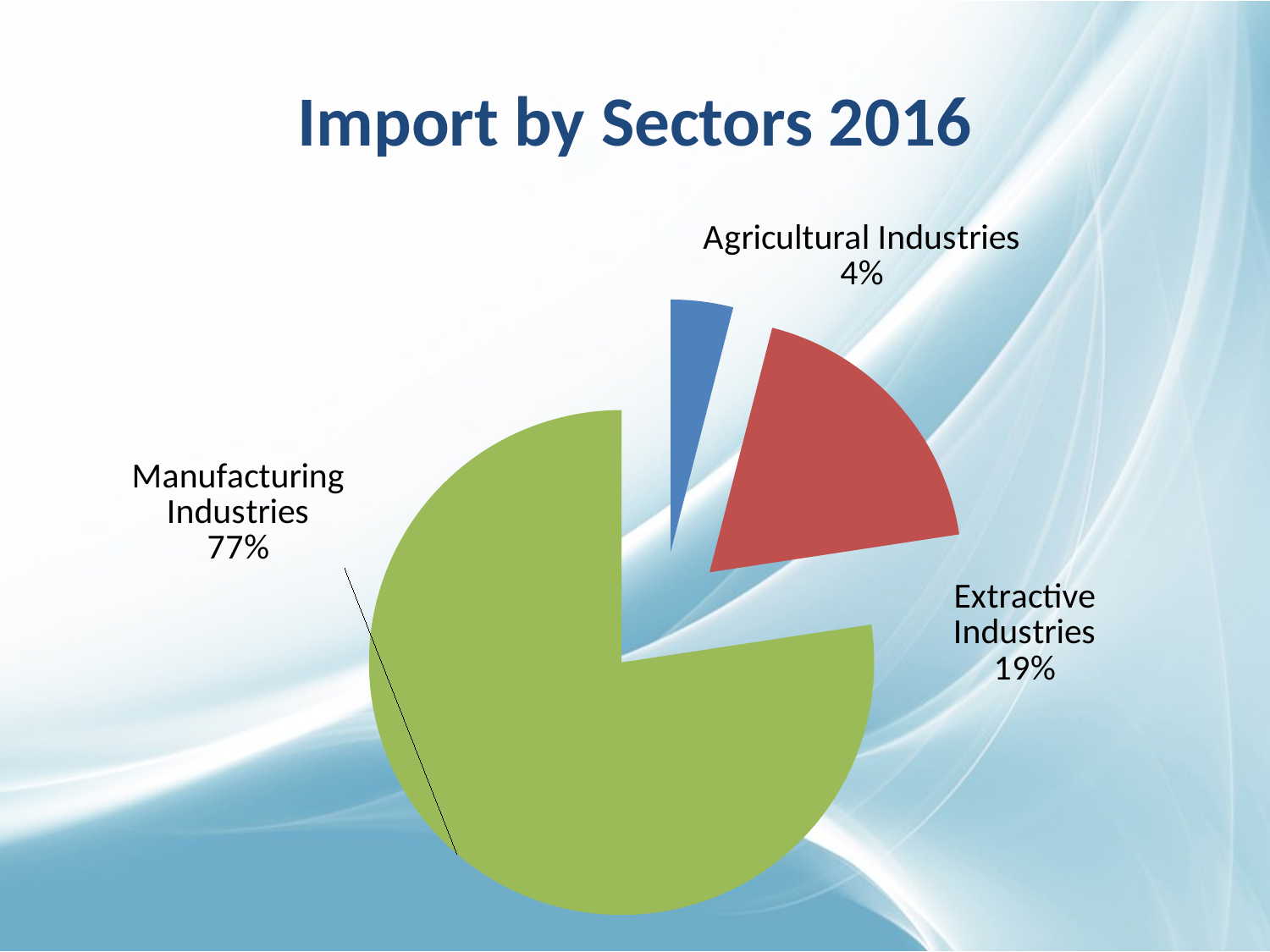
Which sector has the smallest share of imports? Agricultural Industries What is the difference in percentage points between the Manufacturing Industries and Extractive Industries shares? 58 What is the difference in percentage points between the Extractive Industries and Agricultural Industries shares? 15 What is the title of the chart? Import by Sectors 2016 How many sectors are shown in the pie chart? 3 What colour is the Manufacturing Industries slice? Green What share of imports does Agricultural Industries account for? 4% What share of imports does Extractive Industries account for? 19% What share of imports does Manufacturing Industries account for? 77% Which has a larger share of imports, Extractive Industries or Agricultural Industries? Extractive Industries Which sector has the largest share of imports? Manufacturing Industries What kind of chart is shown on the slide? Pie chart